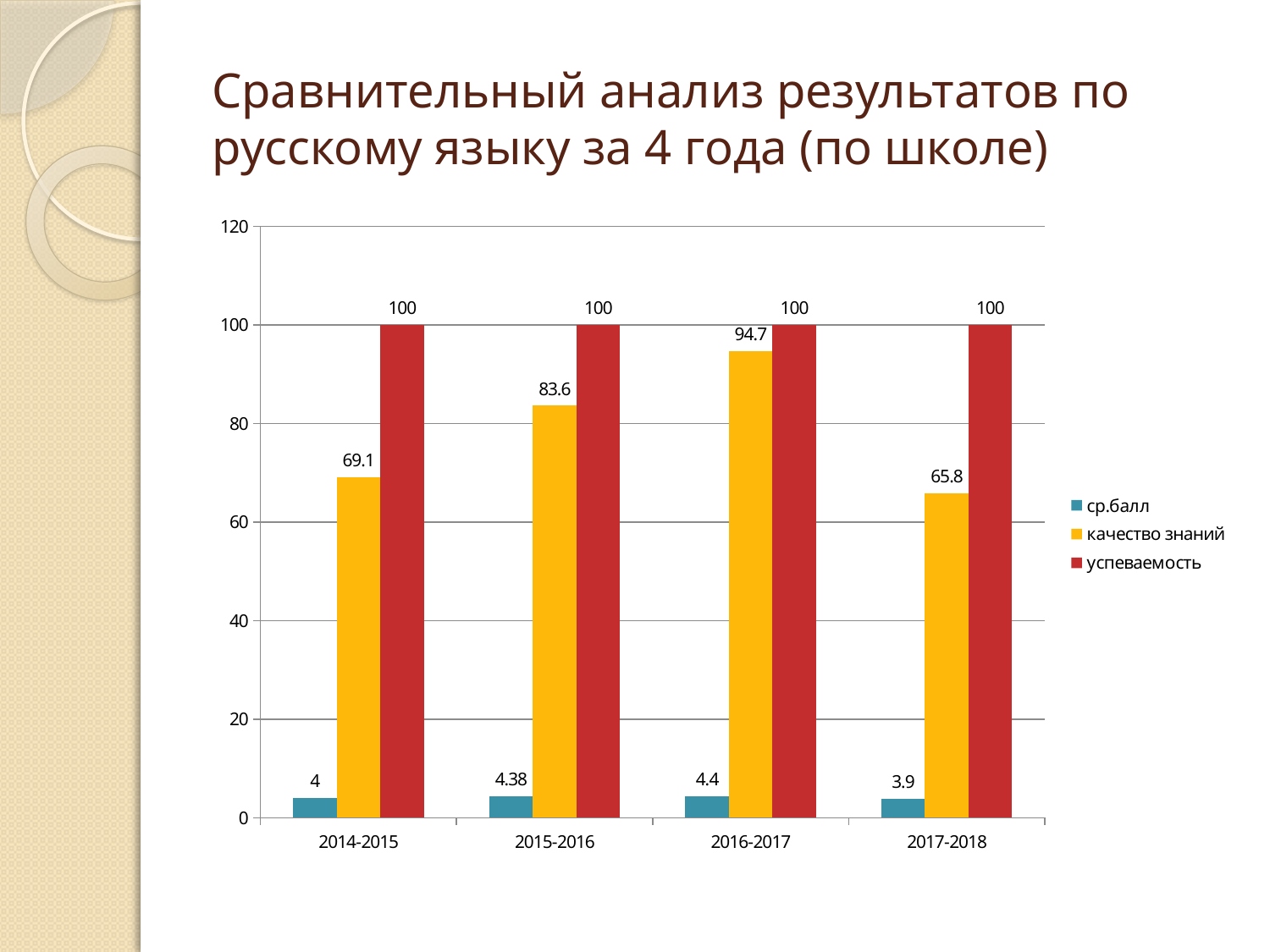
Which is larger: качество знаний in 2014-2015 or in 2015-2016? 2015-2016 How many years are shown on the x axis? 4 What is the value of качество знаний for 2016-2017? 94.7 What is the difference between качество знаний in 2016-2017 and in 2017-2018? 28.9 What is the value of успеваемость for 2017-2018? 100 How many series does the legend list? 3 Which year has the lowest value for ср.балл? 2017-2018 Which year has the highest value for качество знаний? 2016-2017 What kind of chart is shown on the slide? bar chart Does the value of успеваемость change across the four years? No, it stays at 100 What is the value of ср.балл for 2015-2016? 4.38 What colour are the bars for качество знаний? yellow